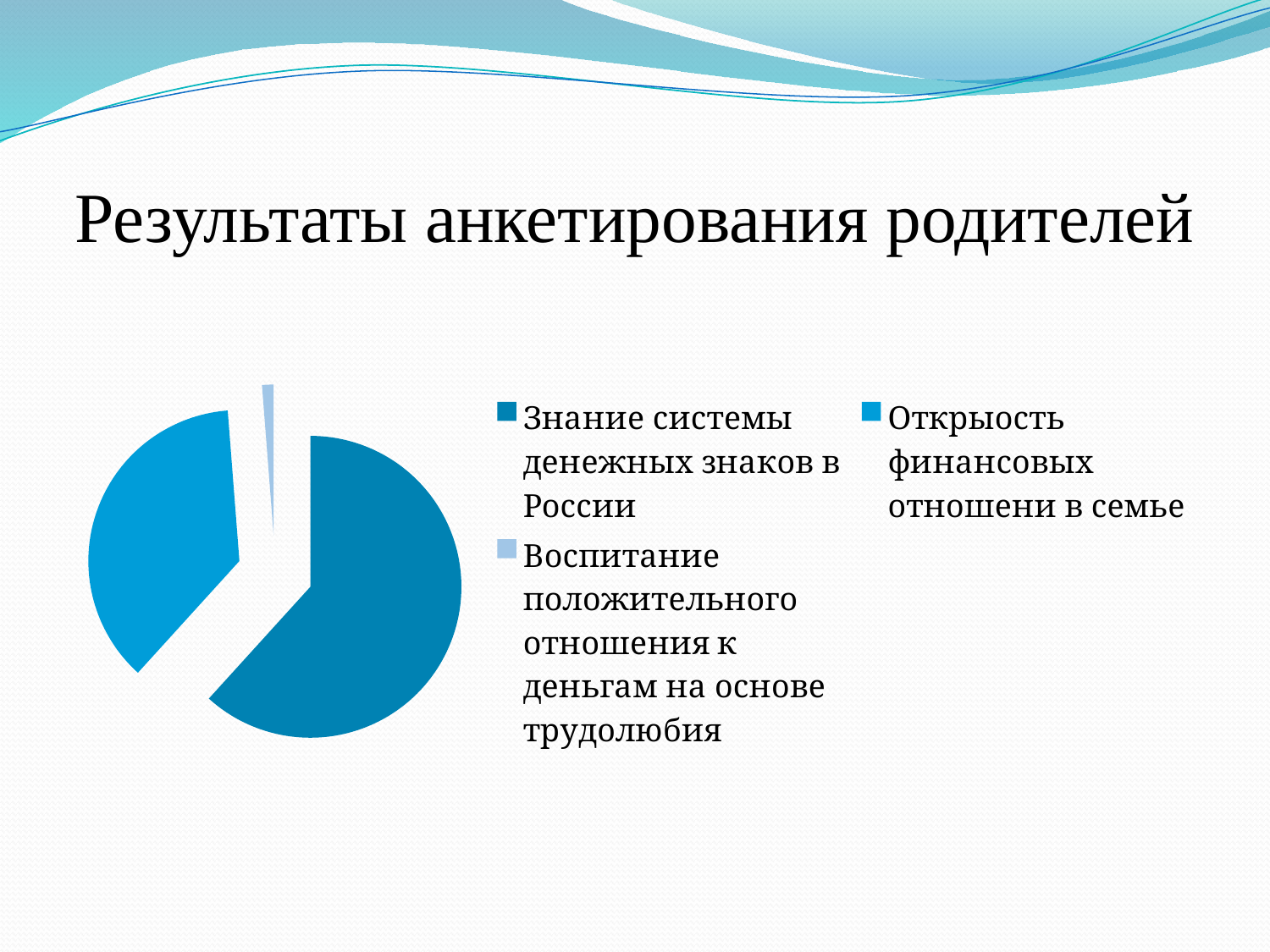
Which category has the smallest slice in the pie chart? Воспитание положительного отношения к деньгам на основе трудолюбия Which legend entry is shown in the lightest blue colour? Воспитание положительного отношения к деньгам на основе трудолюбия What is the title of the slide containing the pie chart? Результаты анкетирования родителей Which slice is larger: "Открыюсть финансовых отношени в семье" or "Воспитание положительного отношения к деньгам на основе трудолюбия"? Открыость финансовых отношени в семье What kind of chart is shown on the slide? pie chart Which slice is larger: "Знание системы денежных знаков в России" or "Открыюсть финансовых отношени в семье"? Знание системы денежных знаков в России Which category has the largest slice in the pie chart? Знание системы денежных знаков в России How many slices does the pie chart have? 3 How many entries does the legend of the pie chart list? 3